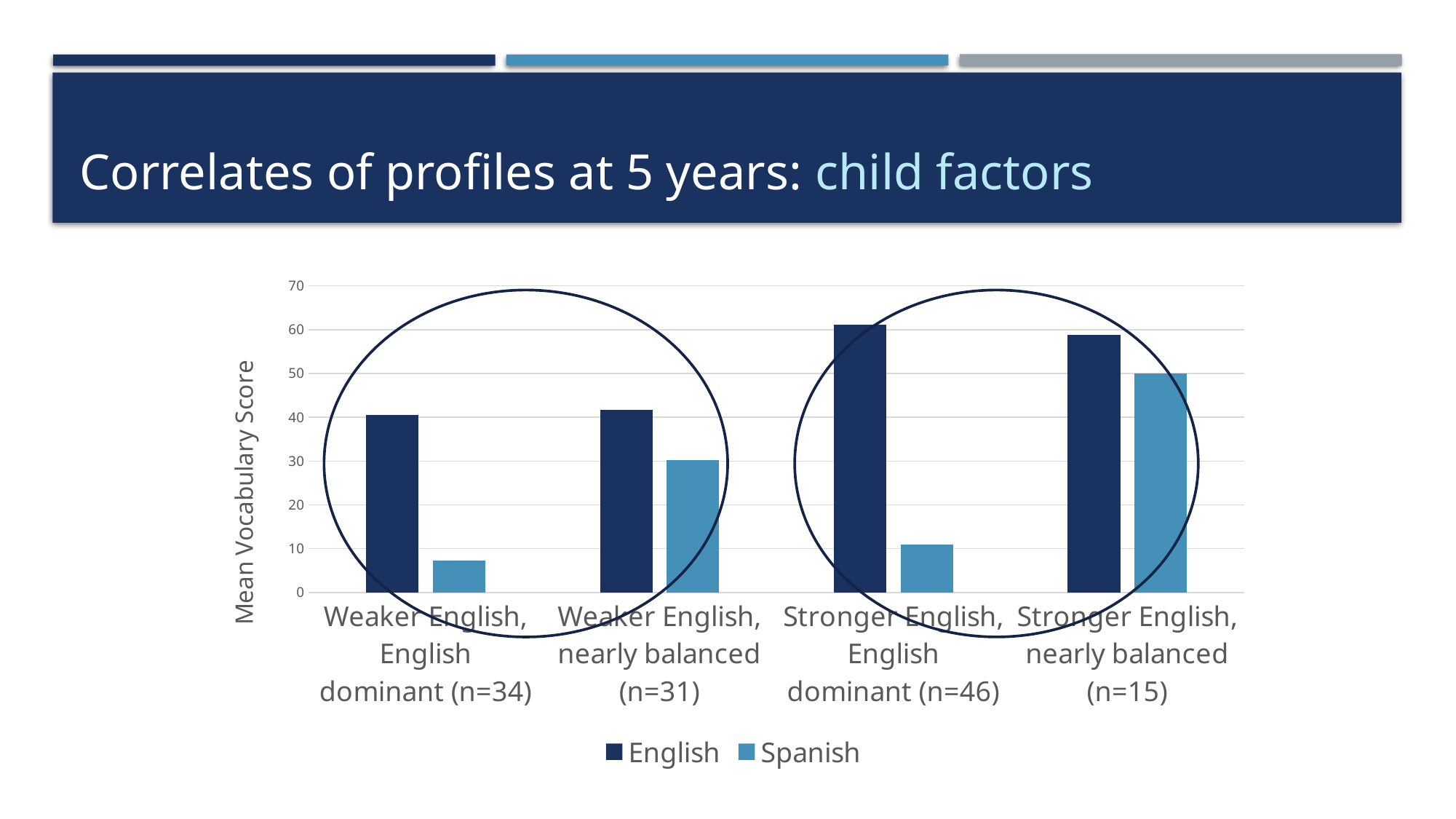
How many profile categories are shown along the x axis? 4 Is the English score for Stronger English, English dominant (n=46) greater or less than 50? greater Which is larger: the Spanish score for Weaker English, nearly balanced (n=31) or the Spanish score for Stronger English, English dominant (n=46)? Weaker English, nearly balanced (n=31) For the Stronger English, English dominant (n=46) group, which is larger: the English or the Spanish score? English What is the label on the vertical axis of the chart? Mean Vocabulary Score Is the Spanish score for Weaker English, English dominant (n=34) greater or less than 10? less How many series does the legend list? 2 Which category has the highest Spanish mean vocabulary score? Stronger English, nearly balanced (n=15) What kind of chart is shown on the slide? Bar chart Is the Spanish score for Stronger English, nearly balanced (n=15) greater or less than 40? greater Which category has the lowest Spanish mean vocabulary score? Weaker English, English dominant (n=34)